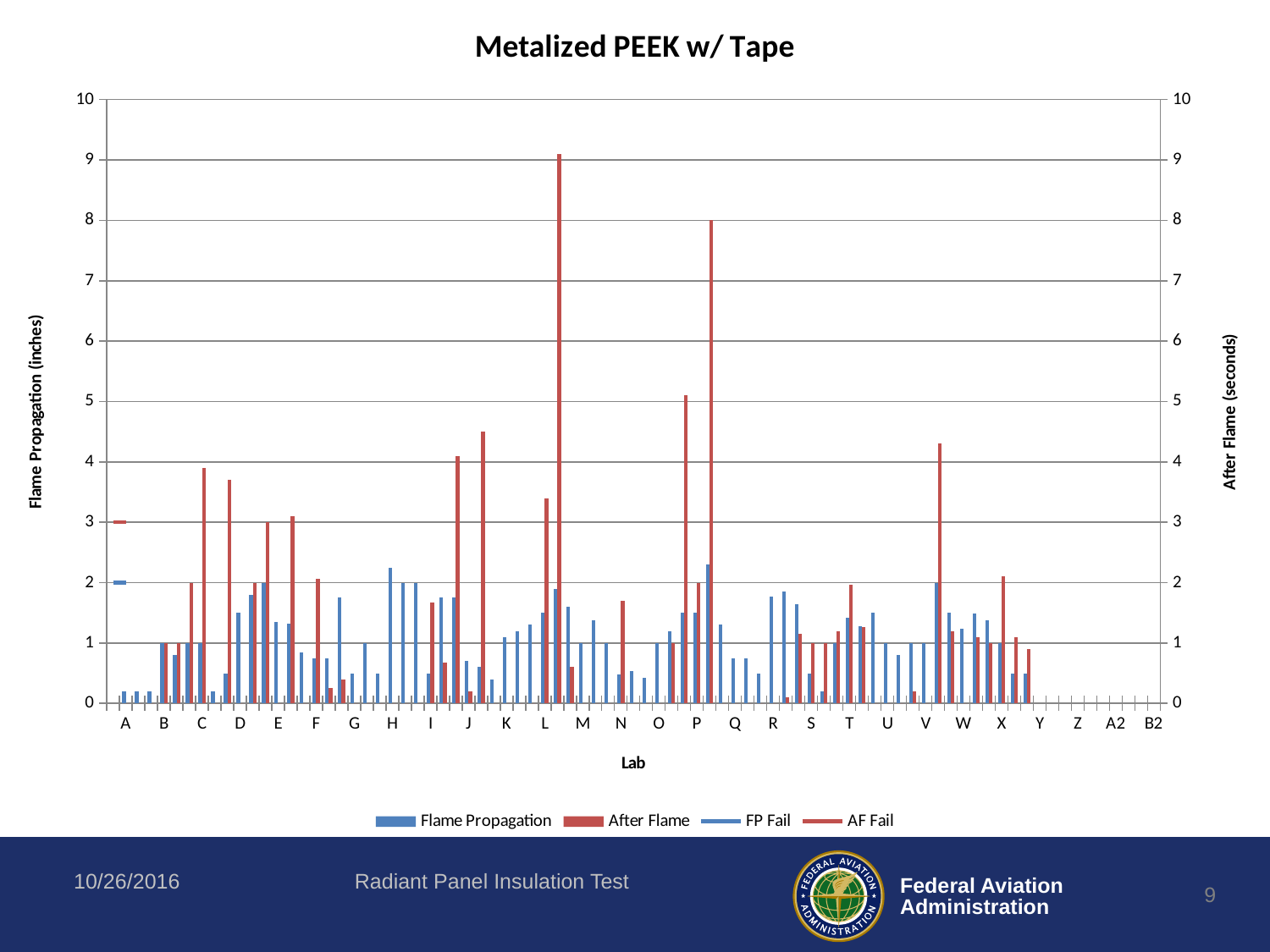
Which series has the tallest bar on the chart, Flame Propagation or After Flame? After Flame Is the tallest After Flame bar greater or less than 5? greater What is the maximum value shown on the left vertical axis? 10 What type of chart is shown on the slide? bar chart Is the tallest Flame Propagation bar greater or less than 3? less Is the tallest After Flame bar greater or less than 8? greater How many lab categories are labeled along the x axis? 28 How many entries does the chart legend list? 4 What is the title of the chart? Metalized PEEK w/ Tape What is the title of the x axis? Lab